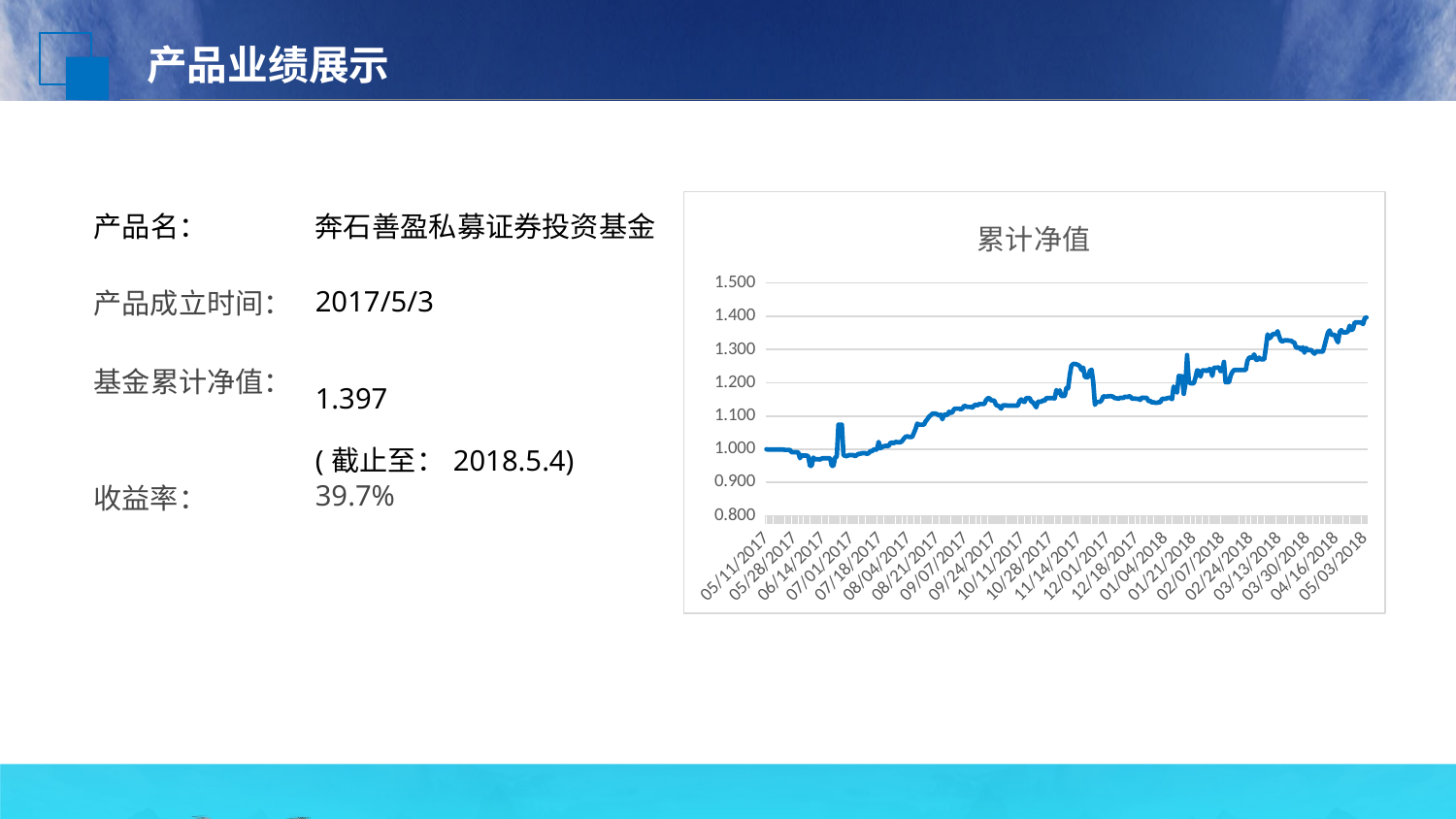
What is the last date label on the x axis? 05/03/2018 What is the title of the chart? 累计净值 What is the highest tick shown on the y axis? 1.500 Overall, does the plotted value rise or fall from the left of the x axis to the right? rise Is the value at 05/11/2017 greater or less than 1.100? less Is the value at 01/21/2018 greater or less than 1.100? greater Which is larger, the value at 03/13/2018 or the value at 12/18/2017? 03/13/2018 Which is larger, the value at 05/03/2018 or the value at 05/11/2017? 05/03/2018 Is the value at 09/24/2017 greater or less than 1.000? greater What kind of chart is shown on the slide? line chart